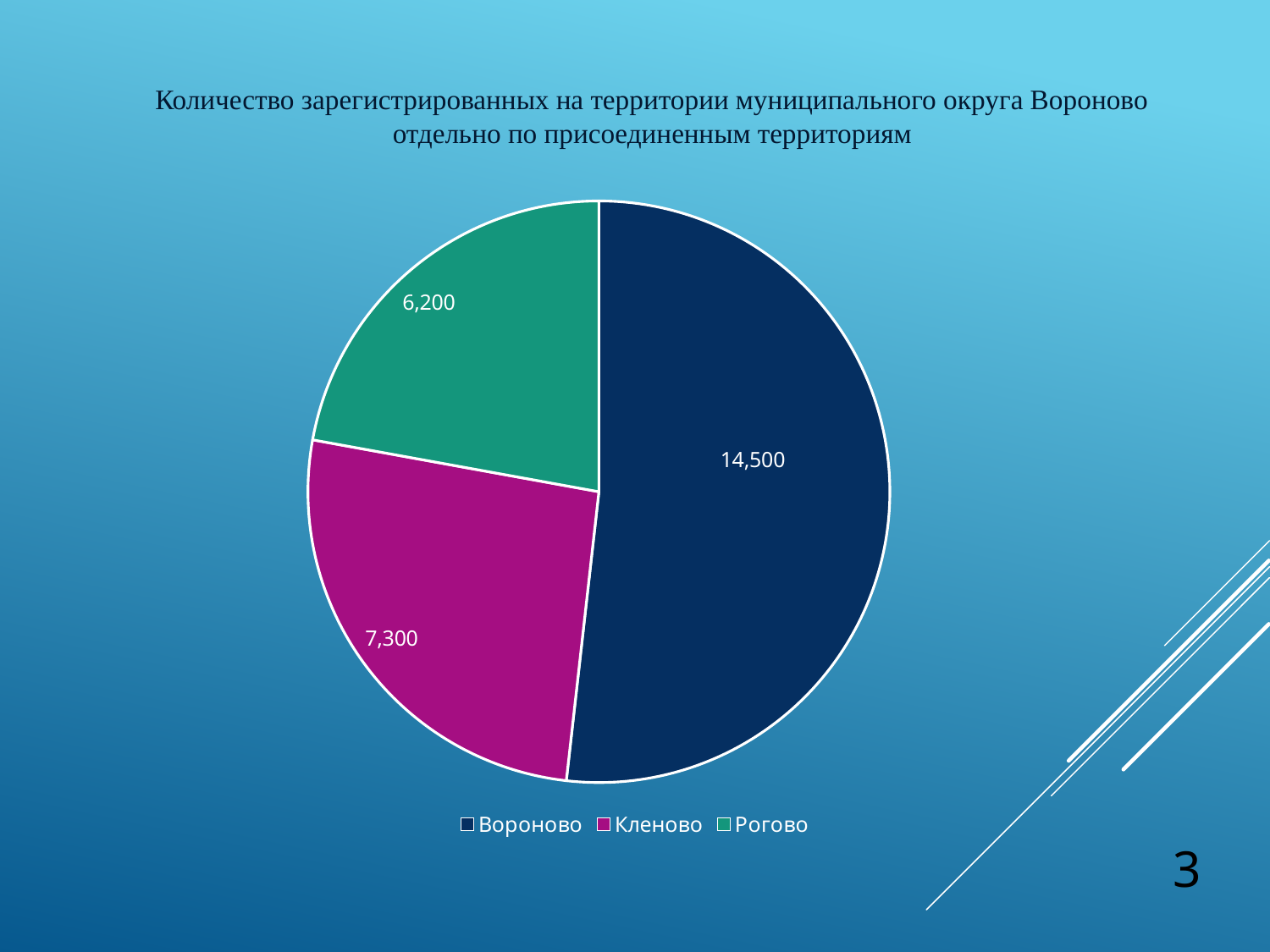
What colour is the slice for Рогово? Green Which territory has the largest number of registered residents? Вороново Which is larger, the value for Кленово or the value for Рогово? Кленово What is the value for Кленово? 7,300 What is the difference between the values for Вороново and Кленово? 7,200 What is the difference between the values for Кленово and Рогово? 1,100 What is the total of all three slices? 28,000 What is the value for Вороново? 14,500 How many slices does the pie chart have? 3 What is the value for Рогово? 6,200 Which territory has the smallest number of registered residents? Рогово What type of chart is shown on the slide? Pie chart